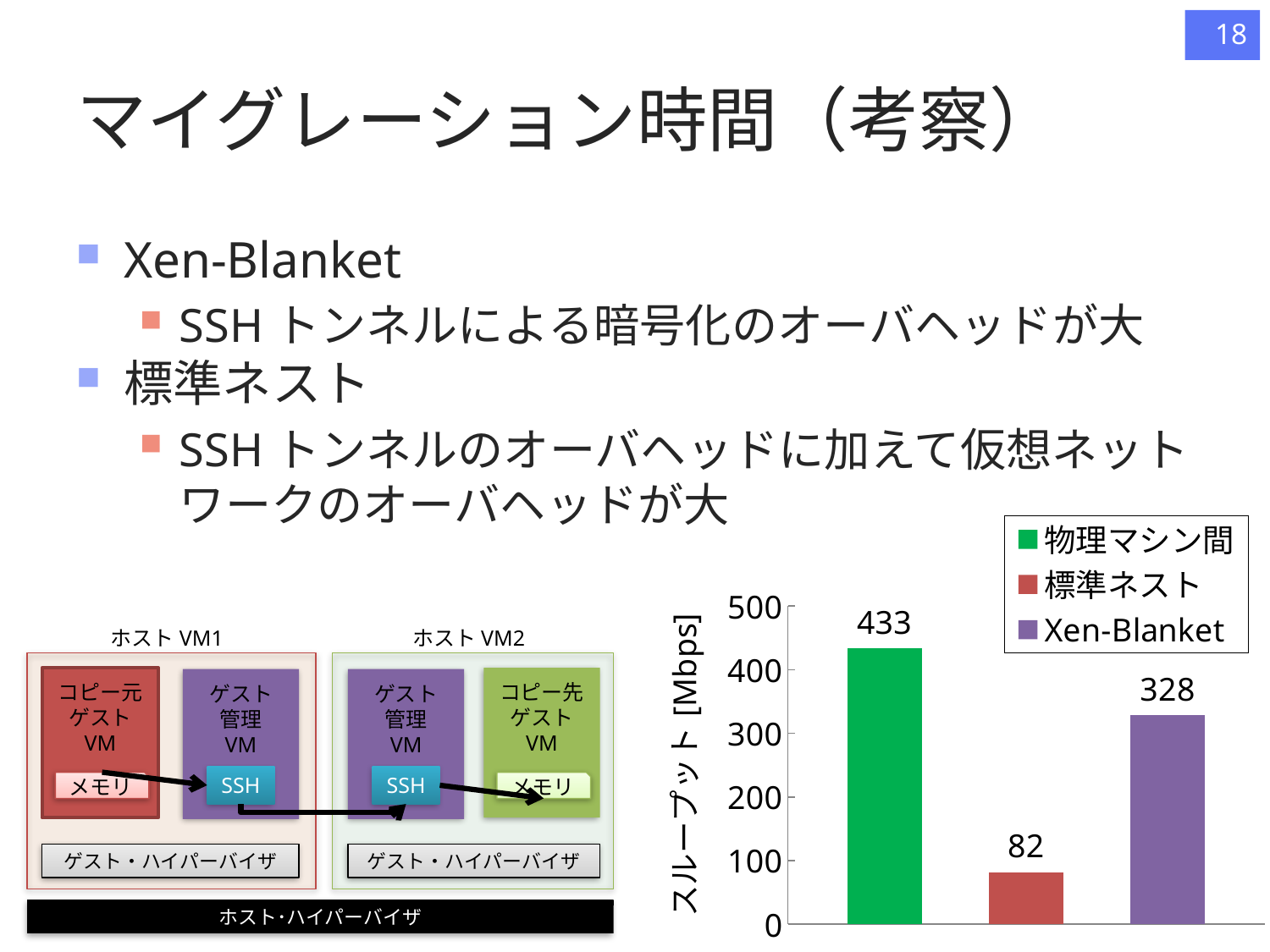
What is the difference in throughput between Xen-Blanket and 標準ネスト? 246 What kind of chart is shown on the slide? bar chart Is the throughput for Xen-Blanket greater or less than 300? greater Which series has the highest throughput in the chart? 物理マシン間 What is the difference in throughput between 物理マシン間 and Xen-Blanket? 105 Which has a higher throughput, Xen-Blanket or 標準ネスト? Xen-Blanket What is the label of the vertical axis of the chart? スループット [Mbps] How many series does the chart legend list? 3 Which series has the lowest throughput in the chart? 標準ネスト What is the throughput value for 物理マシン間 in the chart? 433 What is the throughput value for Xen-Blanket in the chart? 328 What is the throughput value for 標準ネスト in the chart? 82